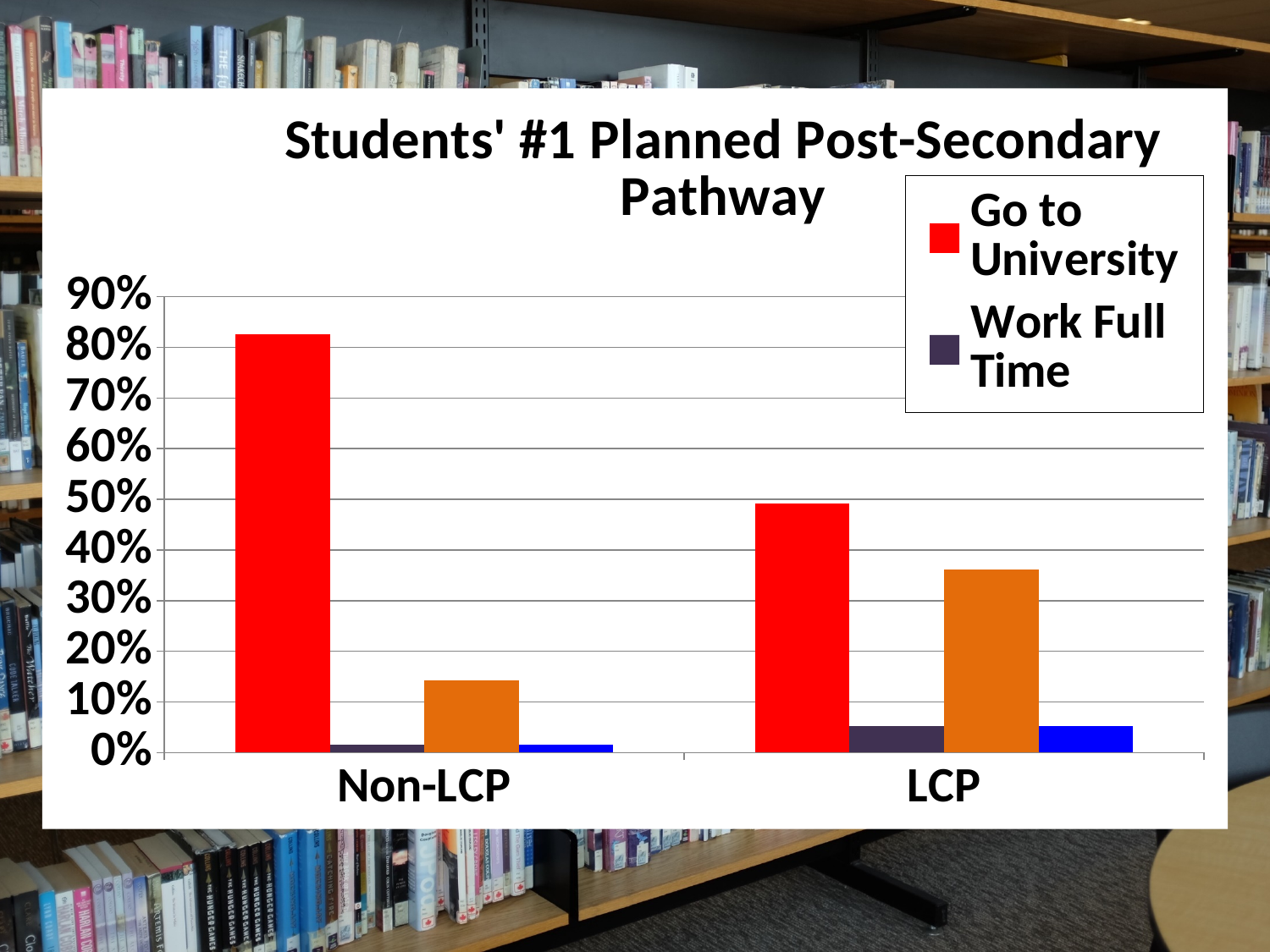
How many series does the chart's legend list? 2 Which category has the higher 'Go to University' value, Non-LCP or LCP? Non-LCP Is the 'Go to University' value for Non-LCP greater or less than 70%? greater Is the 'Work Full Time' value for LCP greater or less than 10%? less Is the 'Work Full Time' value for Non-LCP greater or less than 10%? less What colour represents the 'Go to University' series in the chart? red Does the 'Go to University' value rise or fall from Non-LCP to LCP? fall What kind of chart is shown on the slide? bar chart How many categories are shown on the x axis of the chart? 2 Which category has the higher 'Work Full Time' value, Non-LCP or LCP? LCP What is the title of the chart? Students' #1 Planned Post-Secondary Pathway